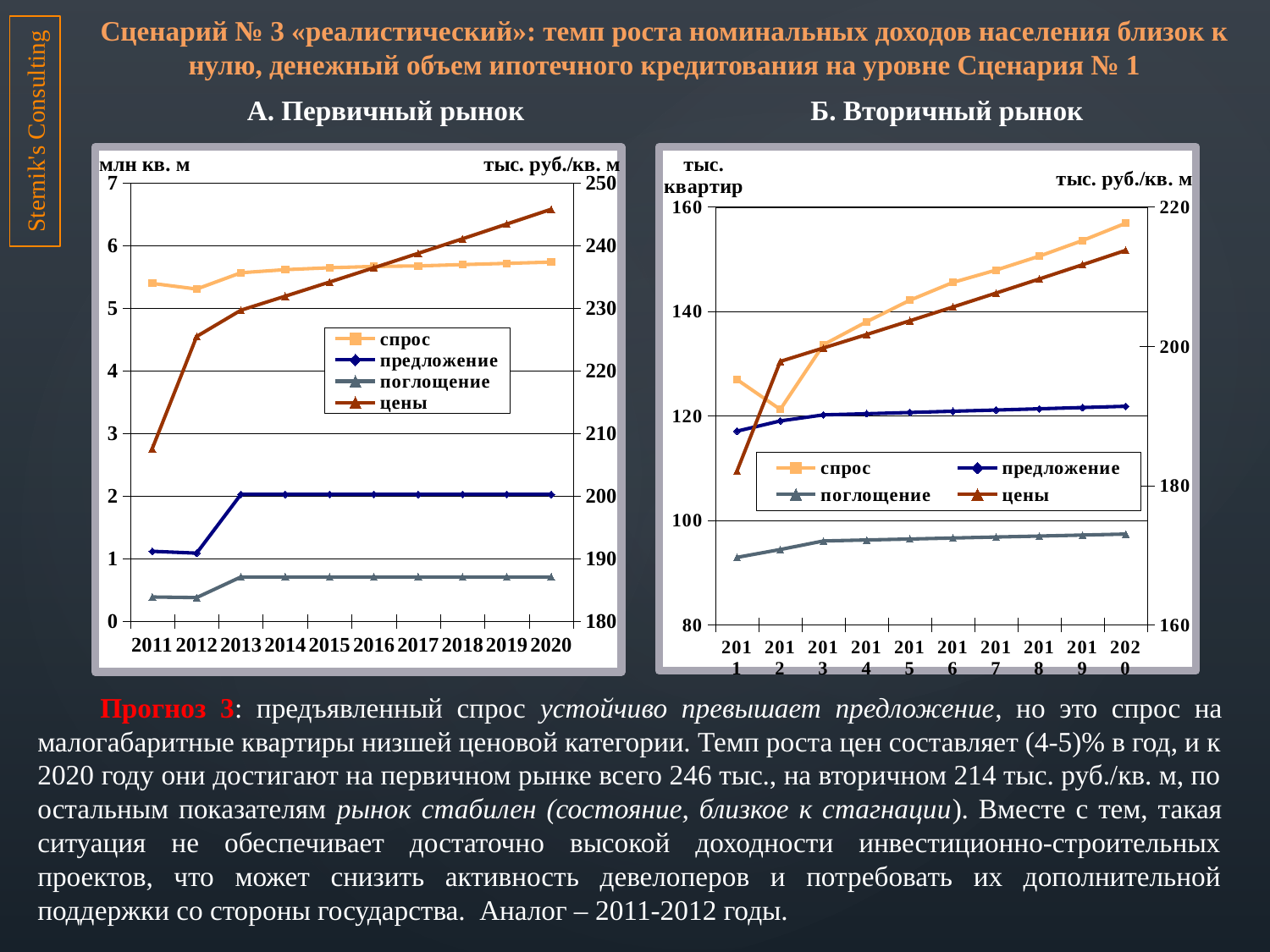
How many series does the legend of the chart «А. Первичный рынок» list? 4 In the chart «А. Первичный рынок», which is larger in 2020: «спрос» or «предложение»? спрос How many years are shown on the x axis of the chart «А. Первичный рынок»? 10 How many series does the legend of the chart «Б. Вторичный рынок» list? 4 In the chart «А. Первичный рынок», is the value for «спрос» in 2020 greater or less than 5? greater In the chart «Б. Вторичный рынок», is the value for «поглощение» in 2011 greater or less than 100? less What unit is shown on the right axis of the chart «Б. Вторичный рынок»? тыс. руб./кв. м What kind of chart is the chart titled «А. Первичный рынок»? line chart In the chart «А. Первичный рынок», do the values of the series «цены» rise or fall from 2011 to 2020? rise In the chart «А. Первичный рынок», is the value for «предложение» in 2011 greater or less than 2? less In the chart «А. Первичный рынок», which series has the lowest values on the left axis? поглощение